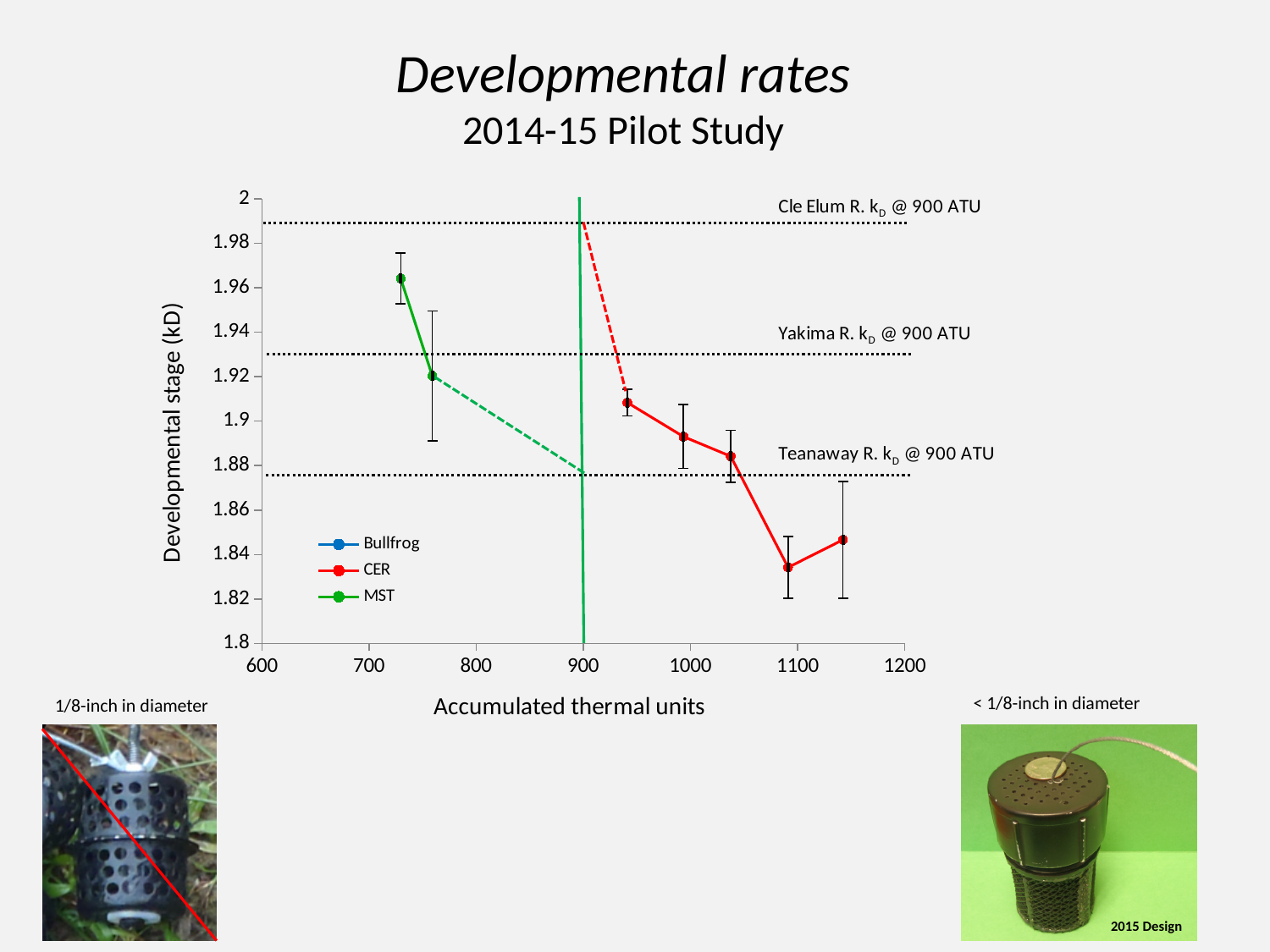
Is the first MST point (near 730 ATU) greater or less than 1.94? greater What colour is the CER series in the chart? red Is the last CER point (near 1140 ATU) greater or less than 1.86? less Which series contains the lowest plotted point on the chart? CER How many data points are plotted for the MST series? 2 Which is larger: the first MST point (near 730 ATU) or the first CER point (near 940 ATU)? the first MST point Do the MST values rise or fall as accumulated thermal units increase? fall What kind of chart is shown on the slide? line chart How many data points are plotted for the CER series? 5 How many series does the chart legend list? 3 What is the title of the x axis of the chart? Accumulated thermal units Which series contains the highest plotted point on the chart? MST